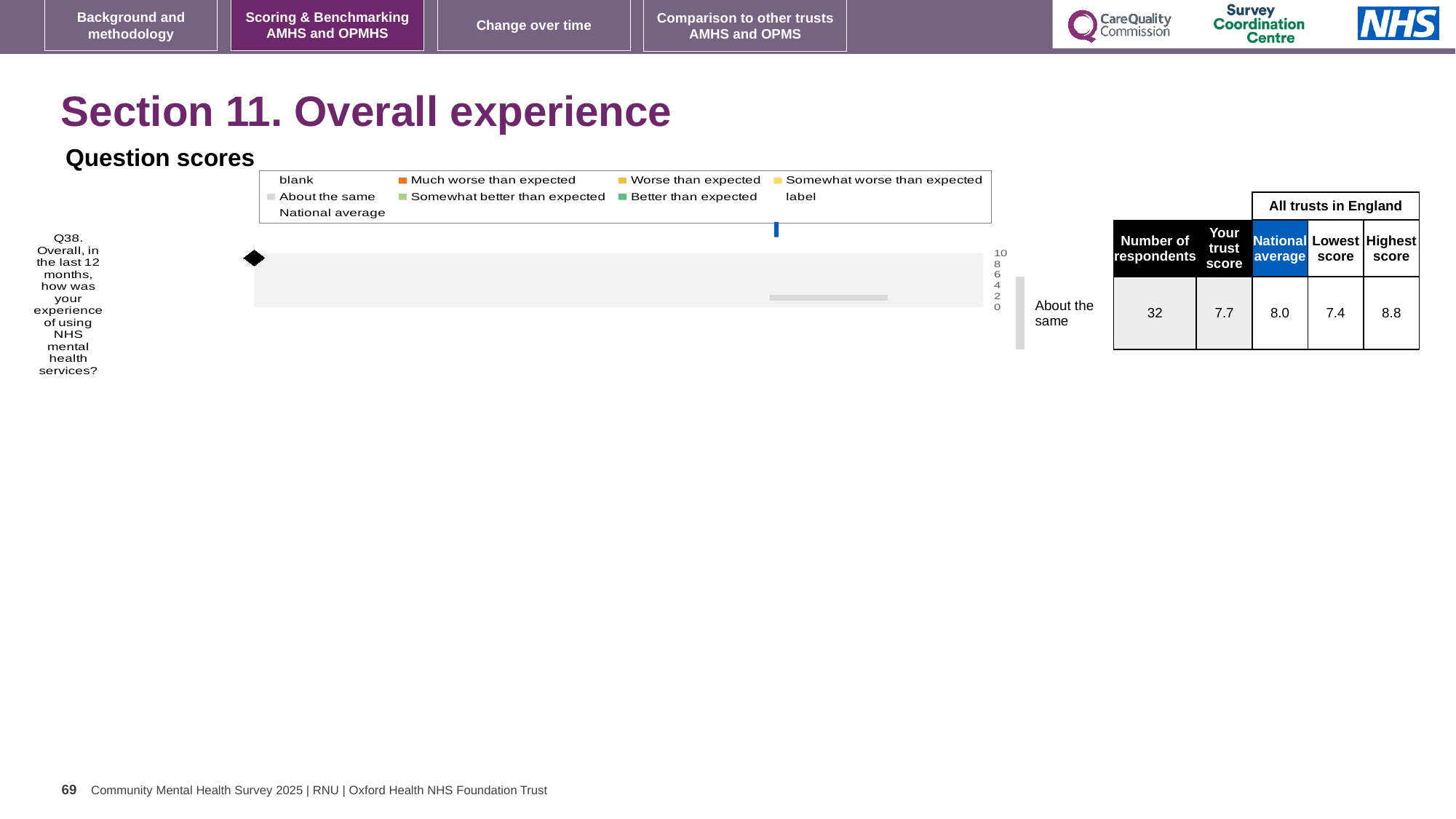
What benchmark category is shown next to the bar for Q38 in the Question scores chart? About the same In the table beside the Question scores chart, what is the difference between the Highest score and the Lowest score for Q38? 1.4 In the table beside the Question scores chart, what is the Highest score for Q38? 8.8 Which question is plotted in the Question scores chart? Q38. Overall, in the last 12 months, how was your experience of using NHS mental health services? How many entries does the legend of the Question scores chart list? 9 In the table beside the Question scores chart, what is the number of respondents for Q38? 32 In the table beside the Question scores chart, what is the National average for Q38? 8.0 In the table beside the Question scores chart, what is 'Your trust score' for Q38? 7.7 In the table beside the Question scores chart, which is larger for Q38: Your trust score or the National average? National average How many questions (categories) are plotted in the Question scores chart? 1 In the table beside the Question scores chart, what is the Lowest score for Q38? 7.4 What kind of chart is shown under 'Question scores'? bar chart